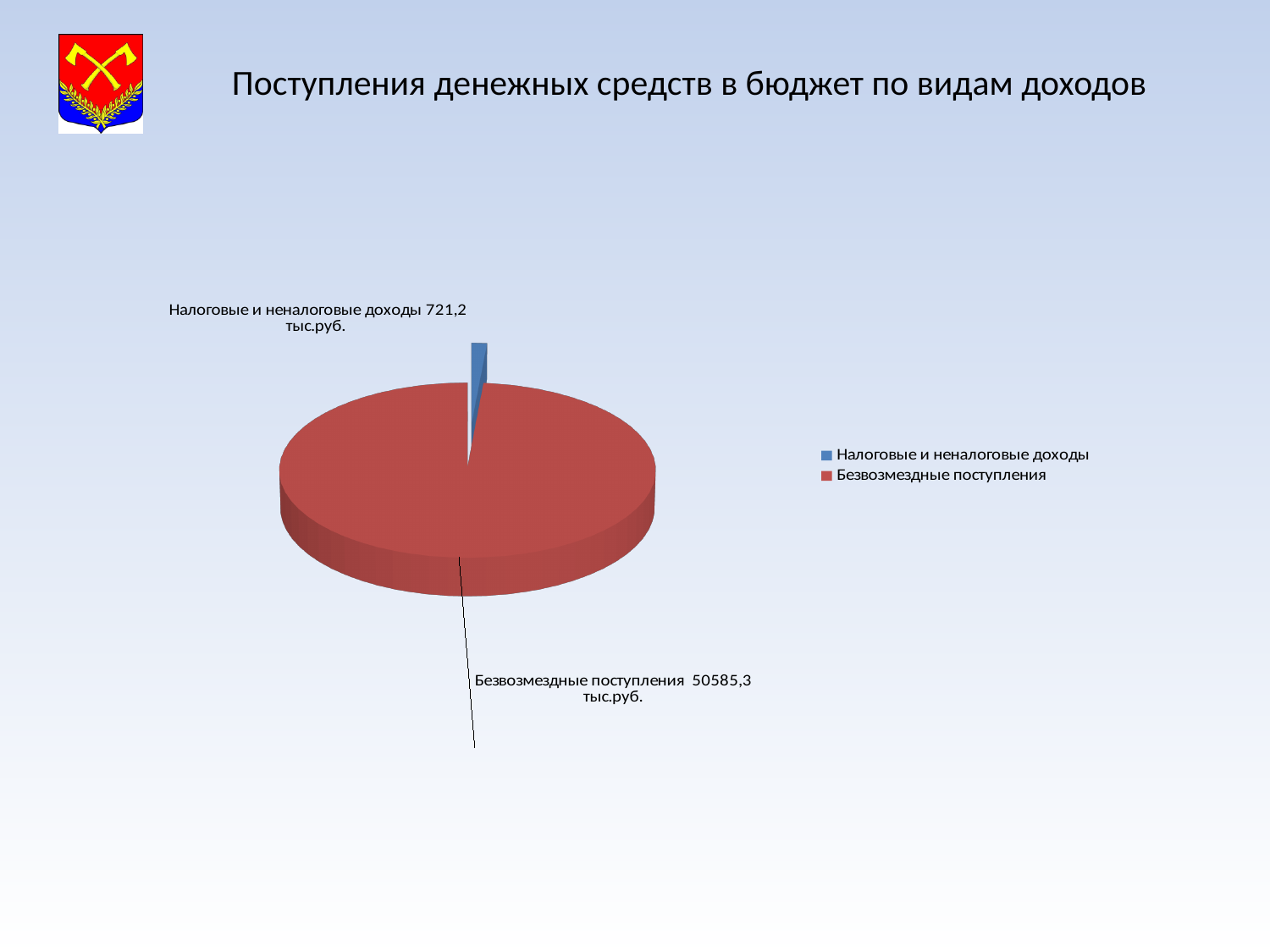
What is the title of the slide? Поступления денежных средств в бюджет по видам доходов How many entries does the legend list? 2 What is the value shown for Налоговые и неналоговые доходы? 721,2 тыс.руб. How many slices does the pie chart have? 2 What colour is the slice for Безвозмездные поступления? Red What is the difference between Безвозмездные поступления and Налоговые и неналоговые доходы? 49864,1 тыс.руб. What kind of chart is shown on the slide? Pie chart Which is larger: Налоговые и неналоговые доходы or Безвозмездные поступления? Безвозмездные поступления What is the value shown for Безвозмездные поступления? 50585,3 тыс.руб. Which category has the largest slice of the pie? Безвозмездные поступления Which category has the smallest slice of the pie? Налоговые и неналоговые доходы What is the total of the two values shown on the pie chart? 51306,5 тыс.руб.